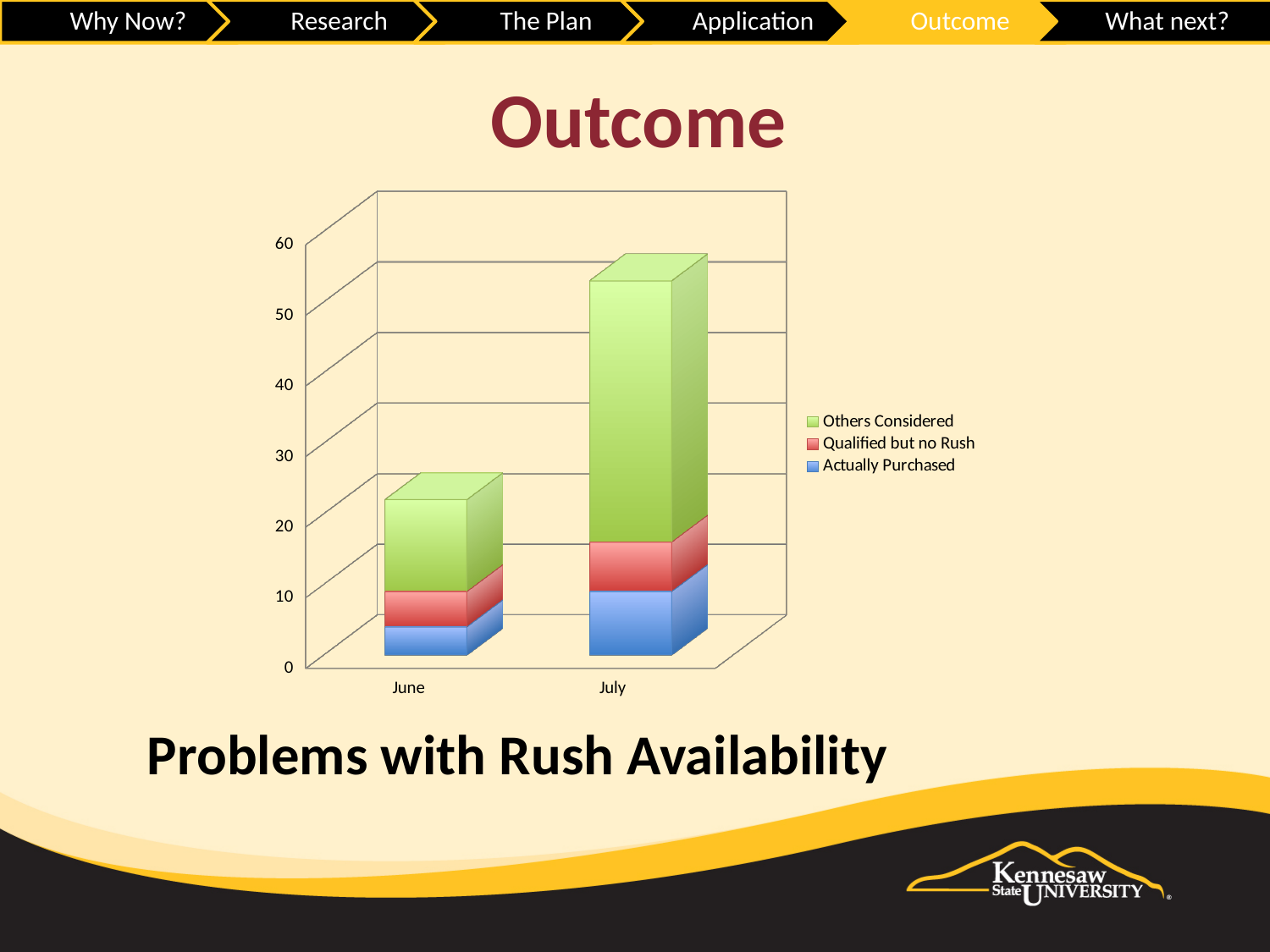
Which month has the taller stacked bar, June or July? July Which series is shown in green in the chart? Others Considered How many series does the chart's legend list? 3 Which month has the larger Actually Purchased segment, June or July? July Do the stacked bar totals rise or fall from June to July? rise Is the total of the July stacked bar greater or less than 40? greater Is the total of the June stacked bar greater or less than 30? less How many categories are shown on the x axis of the chart? 2 What kind of chart is shown on the slide? Stacked bar chart Which series forms the bottom segment of each stacked bar? Actually Purchased Which month has the larger Others Considered segment, June or July? July